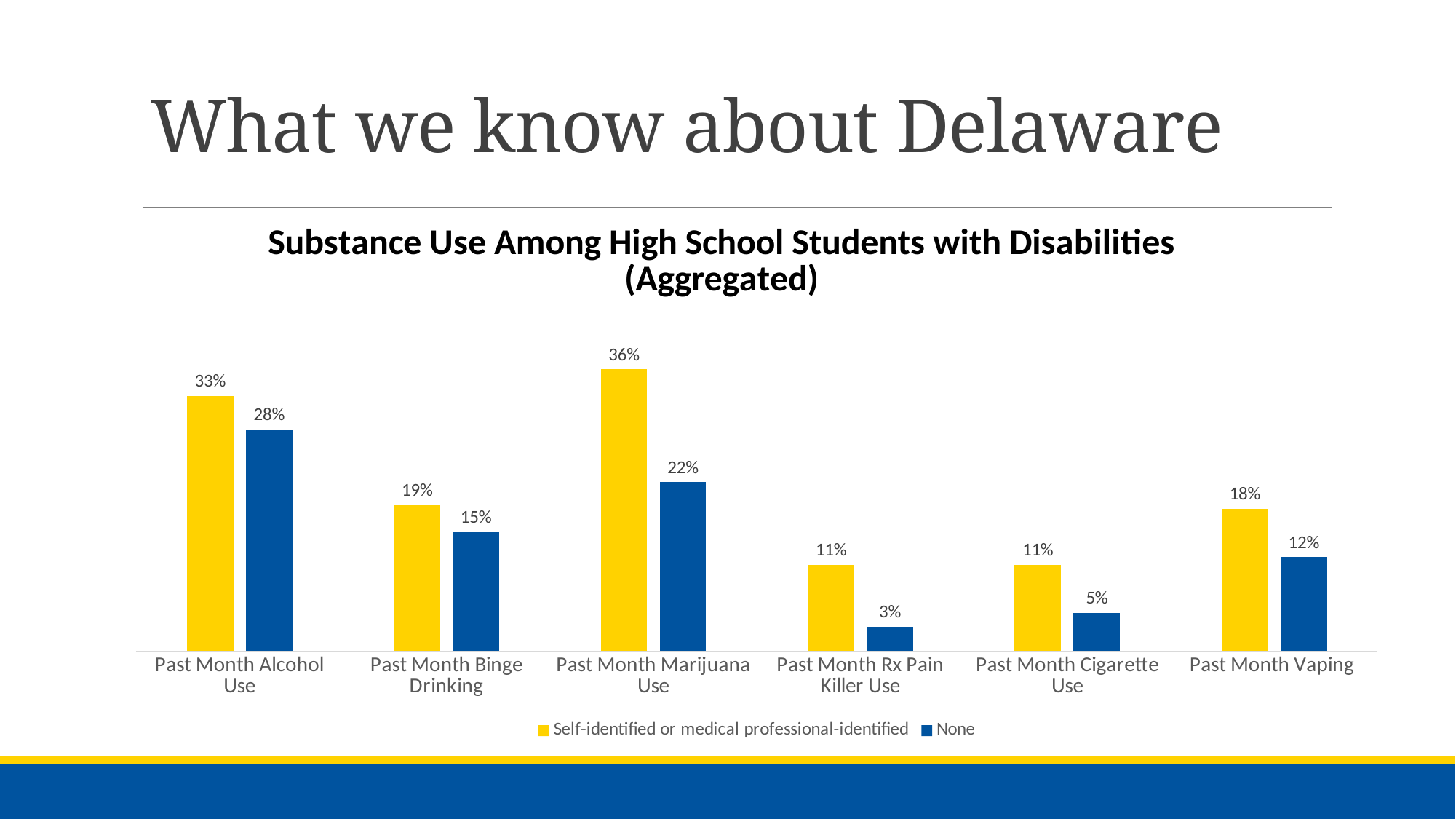
How many series does the legend list? 2 What is the value for Past Month Marijuana Use in the 'Self-identified or medical professional-identified' series? 36% What is the difference between the 'Self-identified or medical professional-identified' and 'None' values for Past Month Alcohol Use? 5% What is the difference between the 'Self-identified or medical professional-identified' and 'None' values for Past Month Marijuana Use? 14% What kind of chart is shown on the slide? Bar chart What is the value for Past Month Vaping in the 'None' series? 12% What is the value for Past Month Rx Pain Killer Use in the 'None' series? 3% How many categories are shown on the x axis? 6 Which category has the lowest value in the 'None' series? Past Month Rx Pain Killer Use What is the title of the chart? Substance Use Among High School Students with Disabilities (Aggregated) Which is larger: the 'None' value for Past Month Binge Drinking or the 'None' value for Past Month Vaping? Past Month Binge Drinking Which category has the highest value in the 'Self-identified or medical professional-identified' series? Past Month Marijuana Use